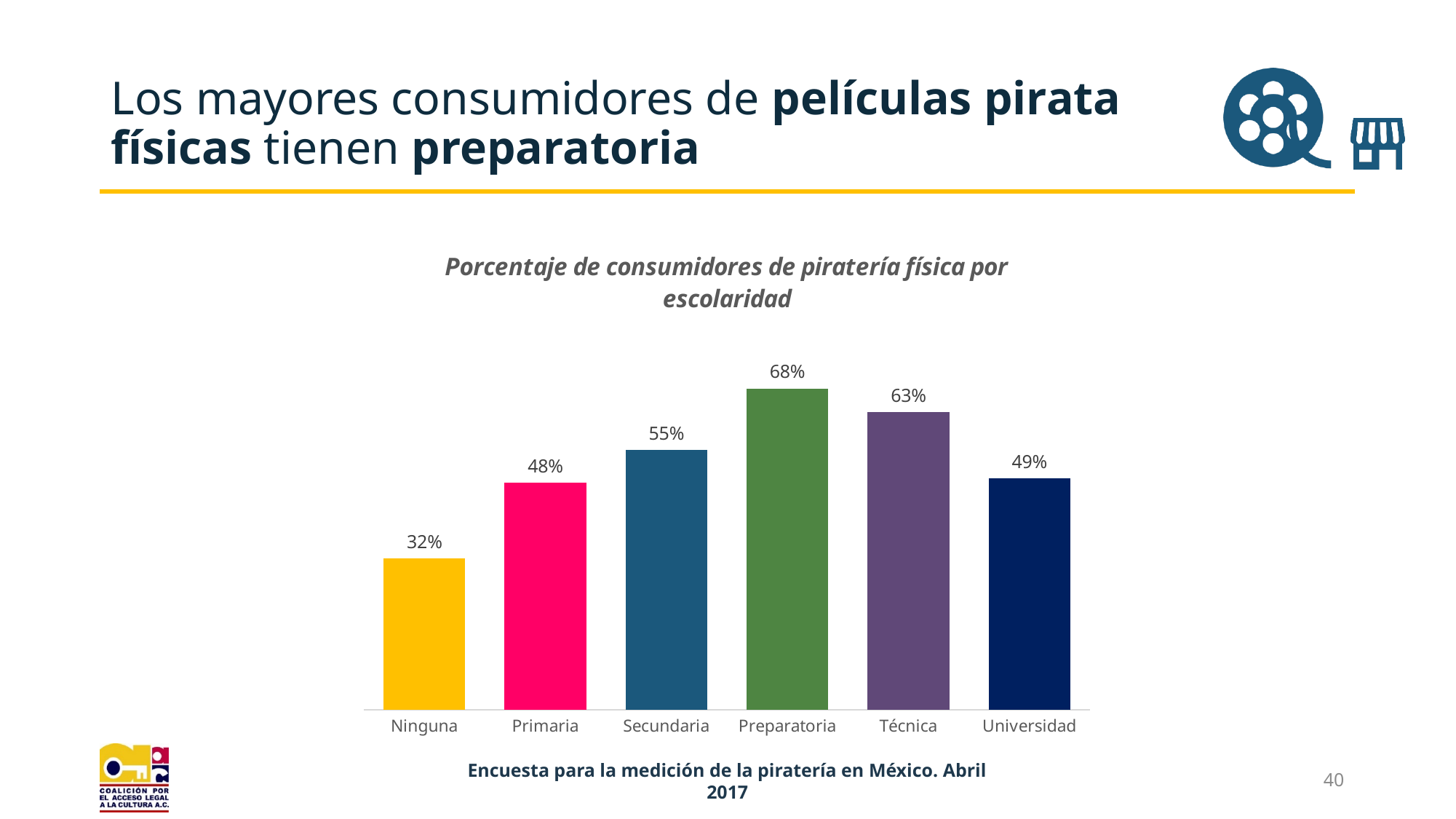
What is the title of the chart? Porcentaje de consumidores de piratería física por escolaridad What kind of chart is shown on the slide? Bar chart Which category has the lowest value? Ninguna What is the difference between the values for Secundaria and Primaria? 7% What is the value for Ninguna? 32% Which is larger, the value for Técnica or the value for Universidad? Técnica Which category has the highest value? Preparatoria What is the value for Universidad? 49% What is the value for Técnica? 63% What is the difference between the values for Preparatoria and Ninguna? 36% What is the value for Preparatoria? 68% How many categories are shown on the x axis? 6